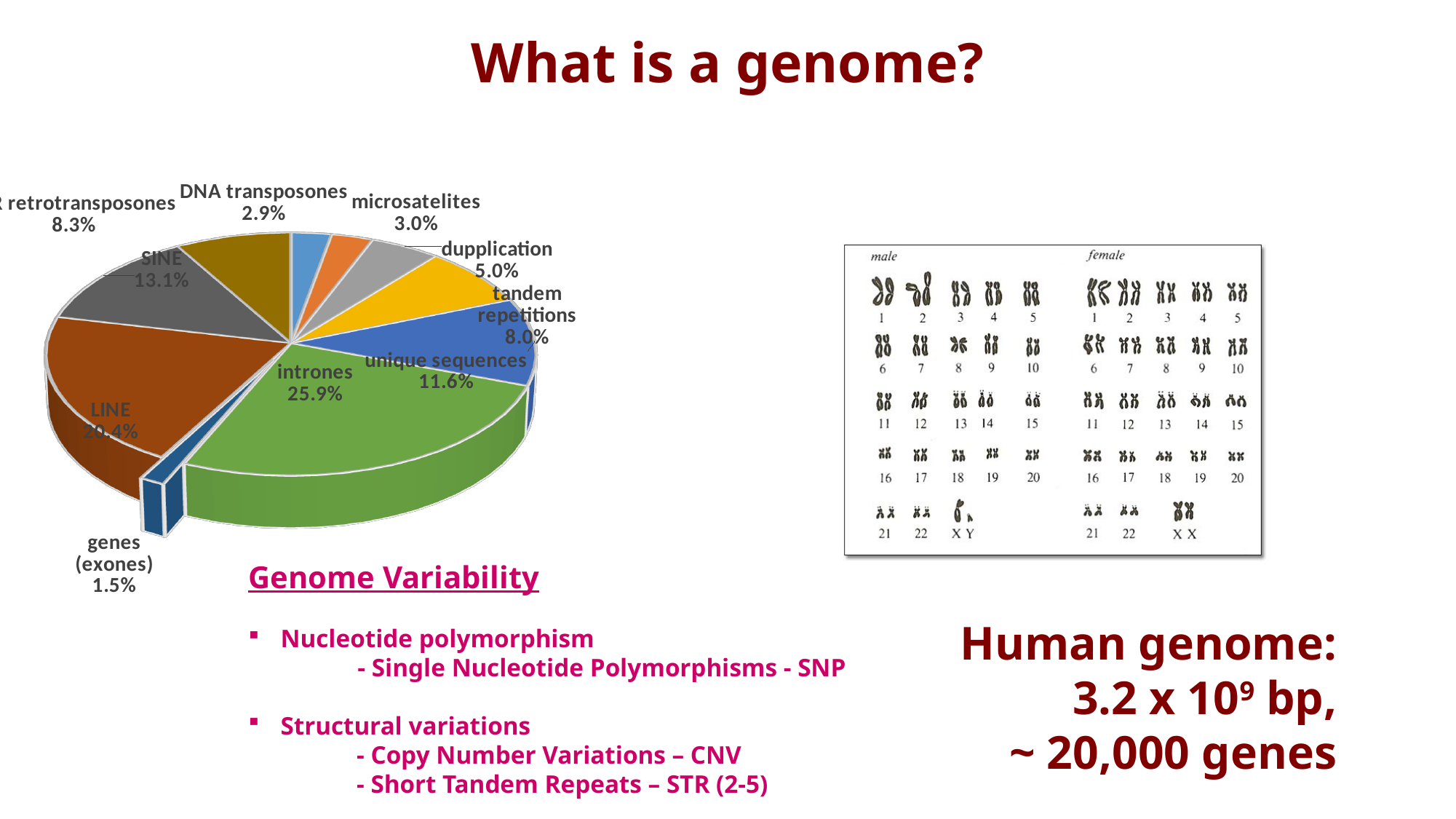
In the pie chart, what percentage is shown for genes (exones)? 1.5% In the pie chart, which is larger: SINE or LINE? LINE In the pie chart, what percentage is shown for LINE? 20.4% In the pie chart, what is the difference between the dupplication share and the microsatelites share? 2.0% In the pie chart, what percentage is shown for intrones? 25.9% How many slices does the pie chart have? 10 What kind of chart is shown on the left of the slide? pie chart In the pie chart, what is the difference between the intrones share and the LINE share? 5.5% Which slice of the pie chart is the largest? intrones Which slice of the pie chart is the smallest? genes (exones) In the pie chart, what percentage is shown for unique sequences? 11.6% In the pie chart, what percentage is shown for tandem repetitions? 8.0%